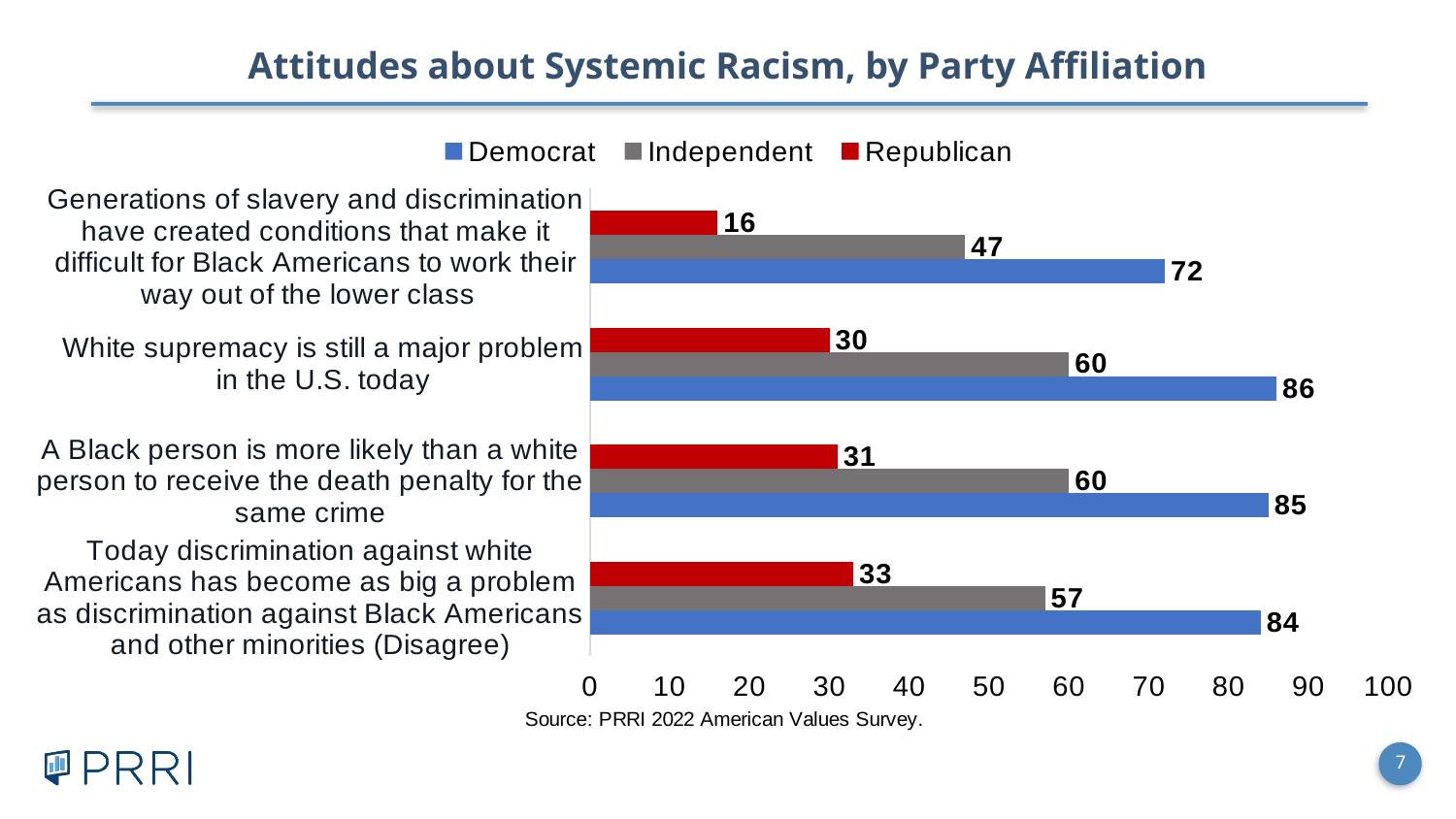
Is the Republican value for "Today discrimination against white Americans has become as big a problem... (Disagree)" greater or less than 40? less Which is larger: the Independent value for "White supremacy is still a major problem in the U.S. today" or the Independent value for "Generations of slavery and discrimination..."? White supremacy is still a major problem in the U.S. today Which colour represents Republican in the chart? Red How many statements (categories) are shown on the chart? 4 Which statement has the highest Democrat value? White supremacy is still a major problem in the U.S. today What is the Independent value for "Today discrimination against white Americans has become as big a problem as discrimination against Black Americans and other minorities (Disagree)"? 57 How many series does the legend list? 3 What kind of chart is shown on the slide? Bar chart What is the Democrat value for "White supremacy is still a major problem in the U.S. today"? 86 What is the Republican value for "Generations of slavery and discrimination have created conditions that make it difficult for Black Americans to work their way out of the lower class"? 16 Which statement has the lowest Republican value? Generations of slavery and discrimination have created conditions that make it difficult for Black Americans to work their way out of the lower class What is the difference between the Democrat and Republican values for "A Black person is more likely than a white person to receive the death penalty for the same crime"? 54